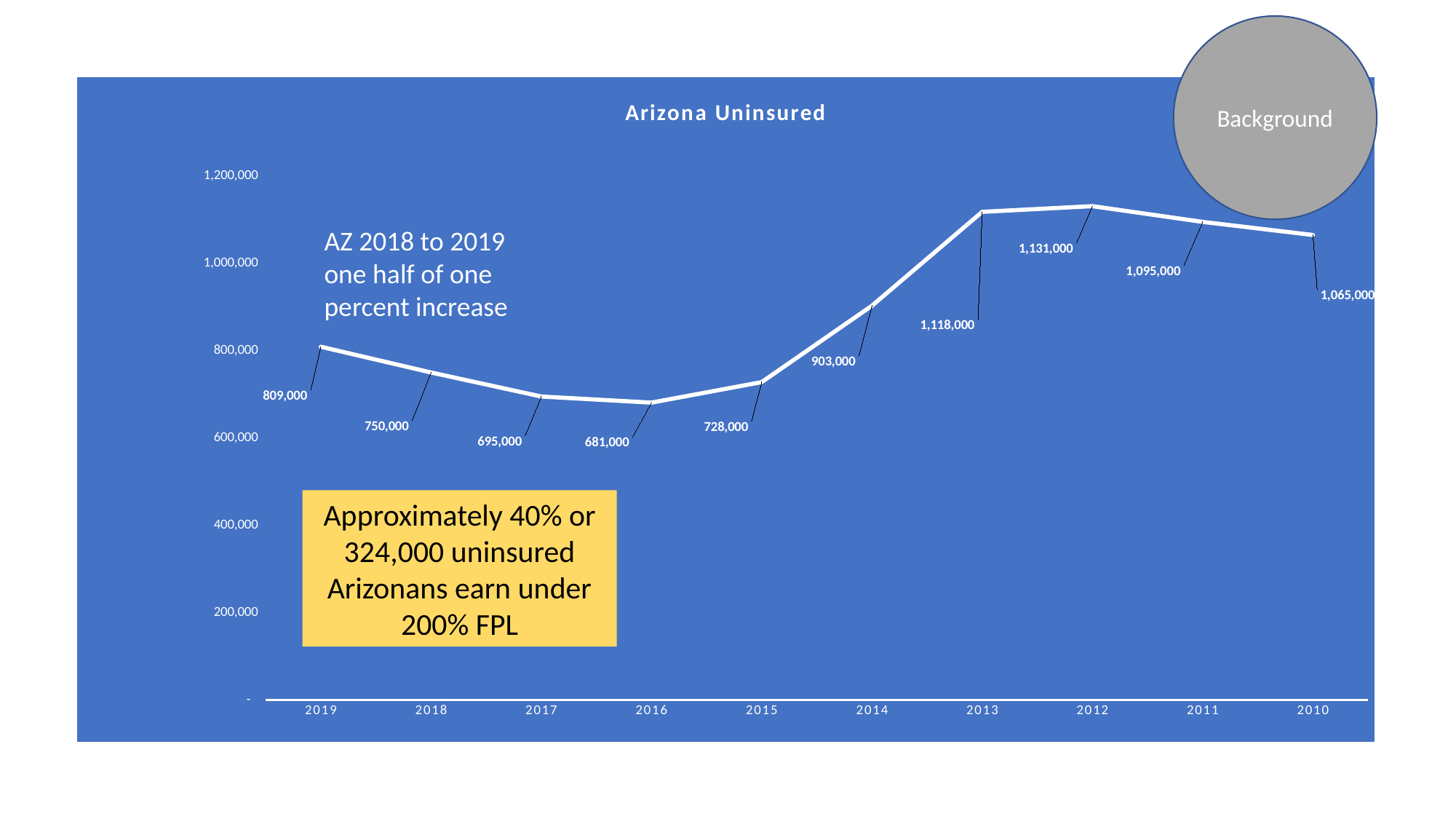
How many data points are plotted in the Arizona Uninsured chart? 10 Moving along the x axis from 2019 to 2016, do the values rise or fall? Fall What is the value for 2011 in the Arizona Uninsured chart? 1,095,000 What is the difference between the values for 2019 and 2018? 59,000 What is the value for 2019 in the Arizona Uninsured chart? 809,000 What is the value for 2014 in the Arizona Uninsured chart? 903,000 What type of chart is shown on the slide? Line chart What is the title of the chart? Arizona Uninsured Which year has the lowest value in the Arizona Uninsured chart? 2016 Which is larger, the value for 2015 or the value for 2017? 2015 What is the difference between the values for 2013 and 2014? 215,000 Which year has the highest value in the Arizona Uninsured chart? 2012